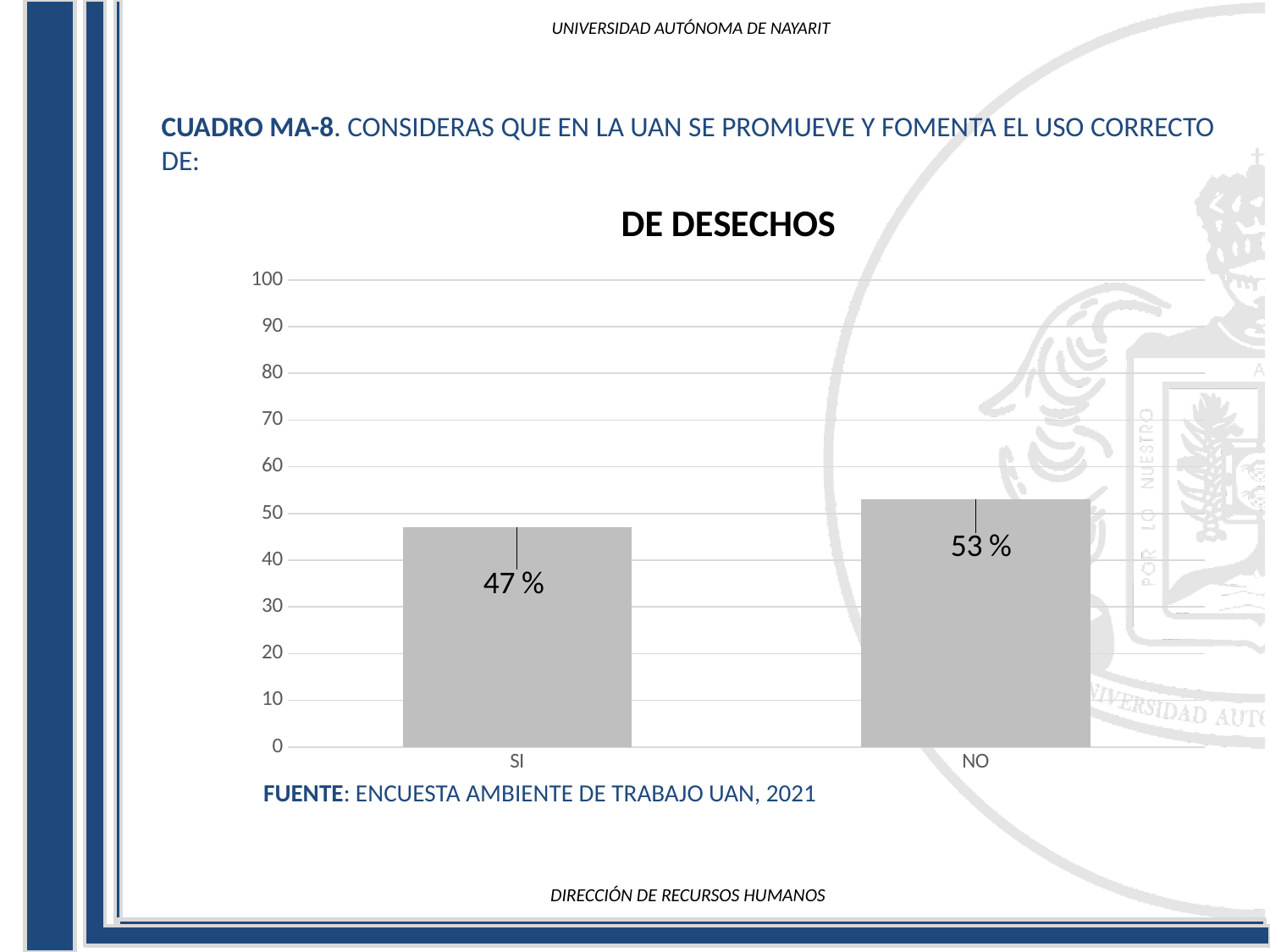
What is the difference between the values for NO and SI? 6 % What is the title of the chart? DE DESECHOS Is the value for NO greater or less than 50? greater Is the value for SI greater or less than 50? less Which category has the highest value? NO What kind of chart is shown? bar chart What is the maximum value shown on the y axis? 100 What is the value for SI? 47 % Which category has the lowest value? SI Which is larger, the value for SI or the value for NO? NO How many categories are shown on the x axis? 2 What is the value for NO? 53 %